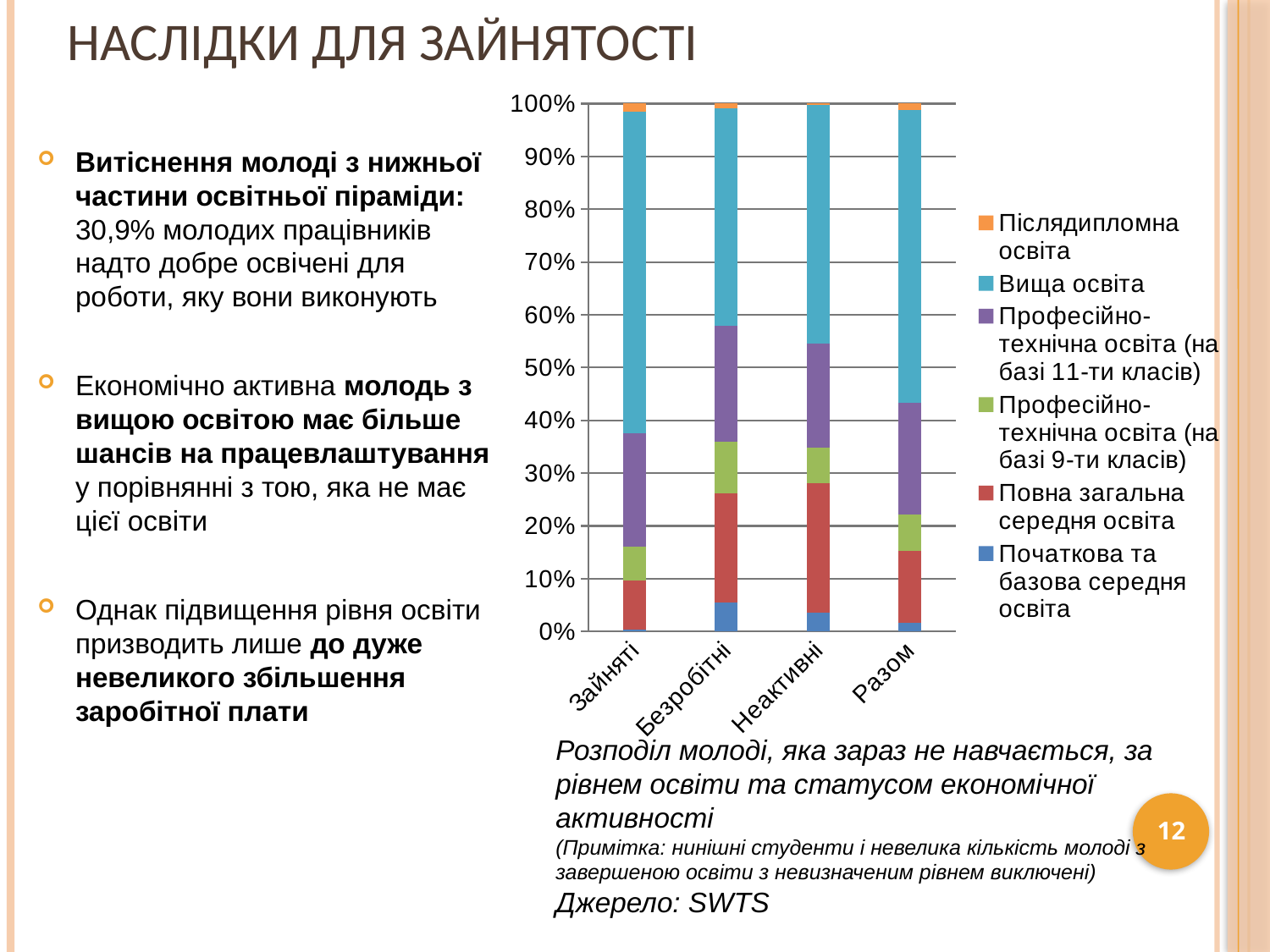
Is the share of 'Вища освіта' in the 'Зайняті' bar greater or less than 50%? greater Which bar has the larger share of 'Вища освіта': 'Зайняті' or 'Безробітні'? Зайняті Which category has the largest share of 'Початкова та базова середня освіта'? Безробітні Which category is listed last on the x axis of the chart? Разом How many series does the chart legend list? 6 How many categories are shown on the x axis of the chart? 4 Which category has the smallest share of 'Повна загальна середня освіта'? Зайняті Is the share of 'Повна загальна середня освіта' in the 'Неактивні' bar greater or less than 20%? greater What kind of chart is shown on the slide? Stacked bar chart Which legend entry is shown in orange? Післядипломна освіта Is the share of 'Вища освіта' in the 'Безробітні' bar greater or less than 50%? less